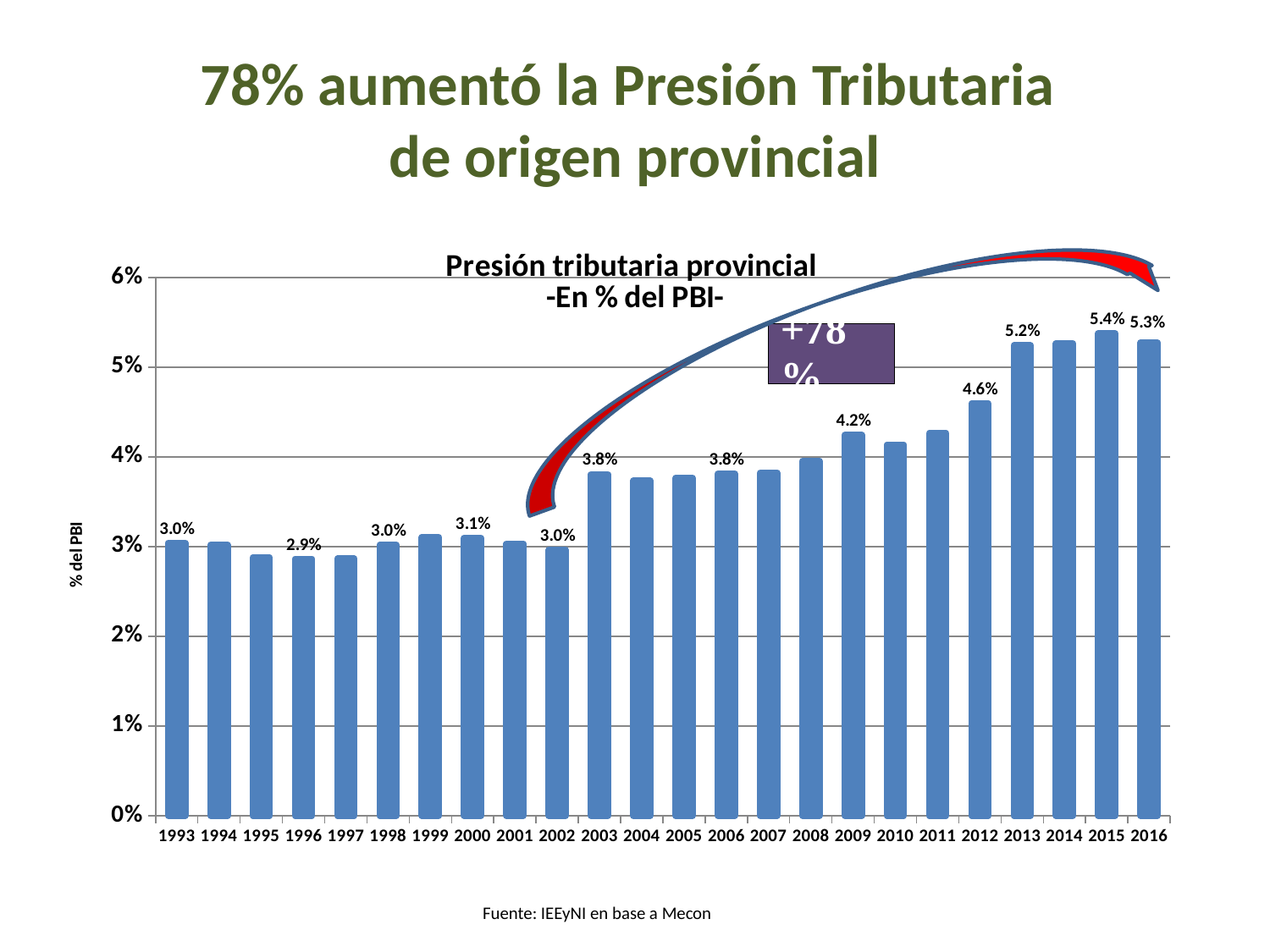
What type of chart is shown on the slide? bar chart What is the value for 2015? 5.4% How many years are shown on the x axis? 24 Is the value for 2010 greater or less than 4%? greater Which year has the highest value? 2015 What is the value for 2012? 4.6% What is the title of the chart? Presión tributaria provincial -En % del PBI- Which is larger, the value for 2003 or the value for 2013? 2013 Is the value for 2004 greater or less than 4%? less What is the value for 2009? 4.2% What is the value for 1993? 3.0% What is the difference between the values for 2015 and 1993? 2.4 percentage points